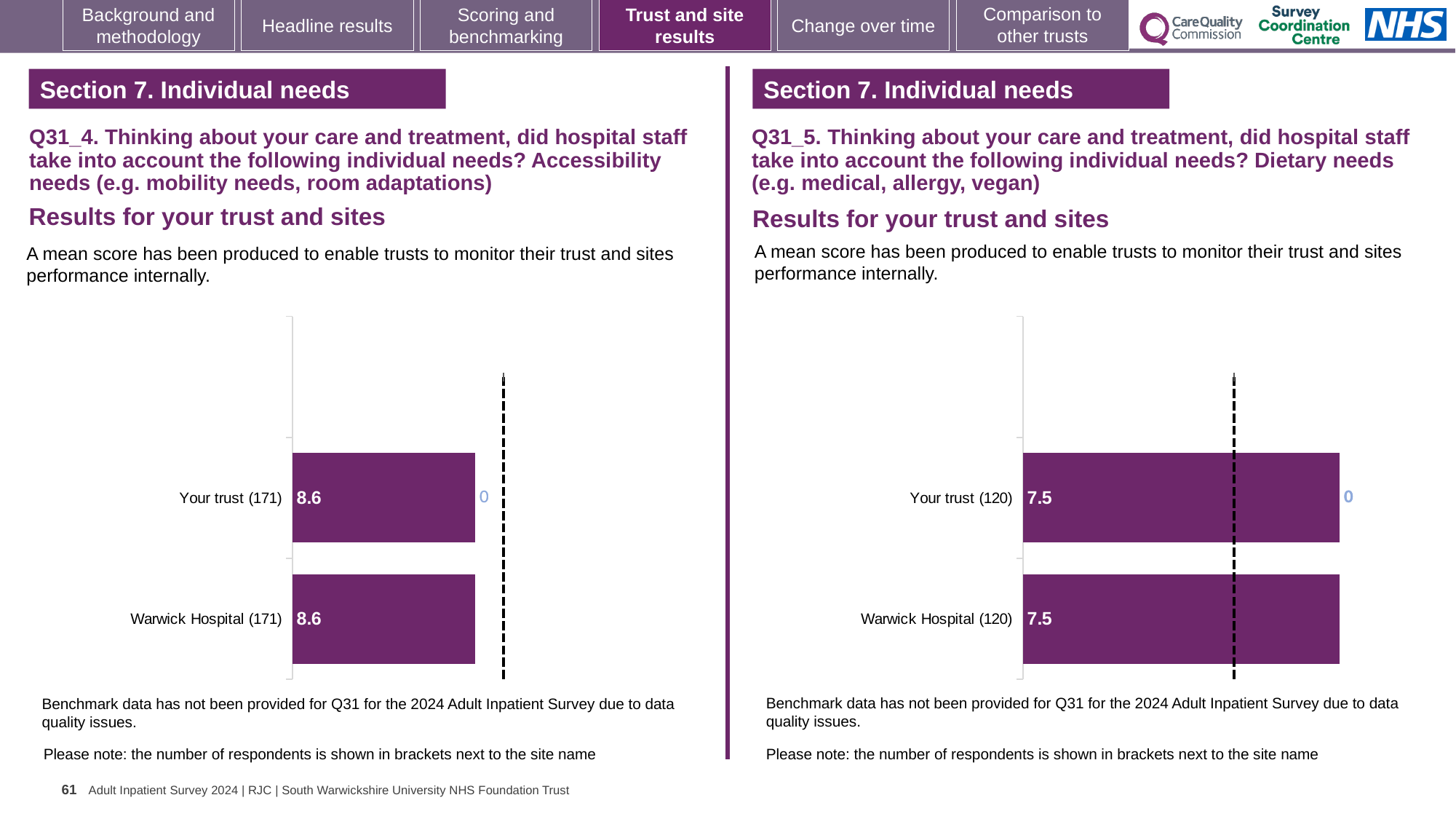
How many bars are plotted on the right chart (Q31_5, dietary needs)? 2 On the right chart (Q31_5, dietary needs), what is the mean score for Your trust (120)? 7.5 On the left chart (Q31_4, accessibility needs), what is the mean score for Warwick Hospital (171)? 8.6 What kind of chart is used on the left (Q31_4, accessibility needs)? Bar chart On the left chart (Q31_4, accessibility needs), what is the difference between the scores for Your trust and Warwick Hospital? 0 On the right chart (Q31_5, dietary needs), what is the difference between the scores for Your trust and Warwick Hospital? 0 How many bars are plotted on the left chart (Q31_4, accessibility needs)? 2 What kind of chart is used on the right (Q31_5, dietary needs)? Bar chart On the right chart (Q31_5, dietary needs), what is the mean score for Warwick Hospital (120)? 7.5 How many respondents are shown in brackets for Warwick Hospital on the left chart (Q31_4, accessibility needs)? 171 How many respondents are shown in brackets for Your trust on the right chart (Q31_5, dietary needs)? 120 On the left chart (Q31_4, accessibility needs), what is the mean score for Your trust (171)? 8.6